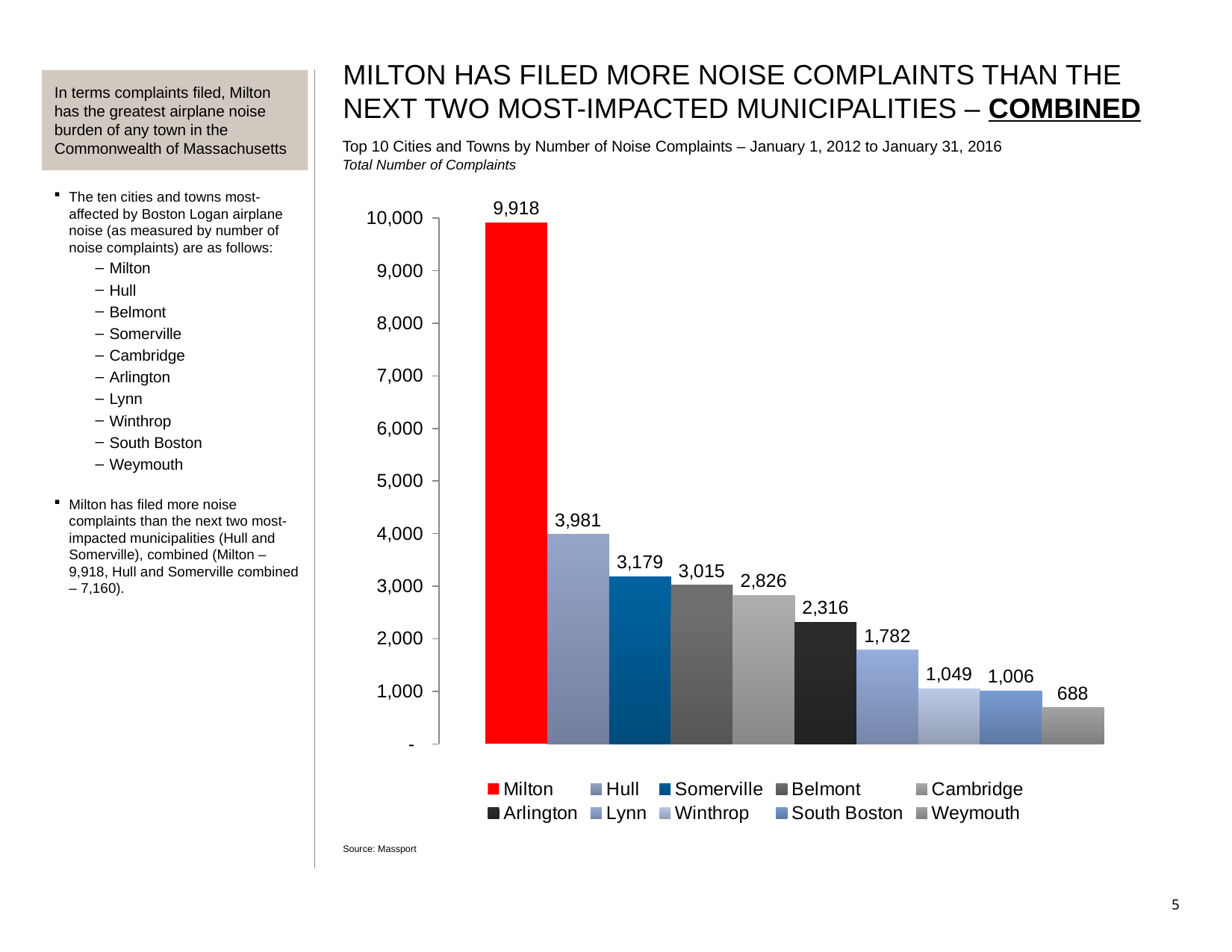
Is the value for Hull greater or less than 5,000? less Which municipality has the lowest number of noise complaints? Weymouth What is the value shown for Somerville? 3,179 Which municipality has the highest number of noise complaints? Milton How many noise complaints did Milton file according to the chart? 9,918 What colour is the bar for Milton? Red What is the difference between the values for Milton and Hull? 5,937 What is the value shown for Weymouth? 688 How many municipalities are shown in the chart? 10 Which has more noise complaints, Arlington or Lynn? Arlington What is the difference between the values for Belmont and Cambridge? 189 What kind of chart is shown on the slide? Bar chart